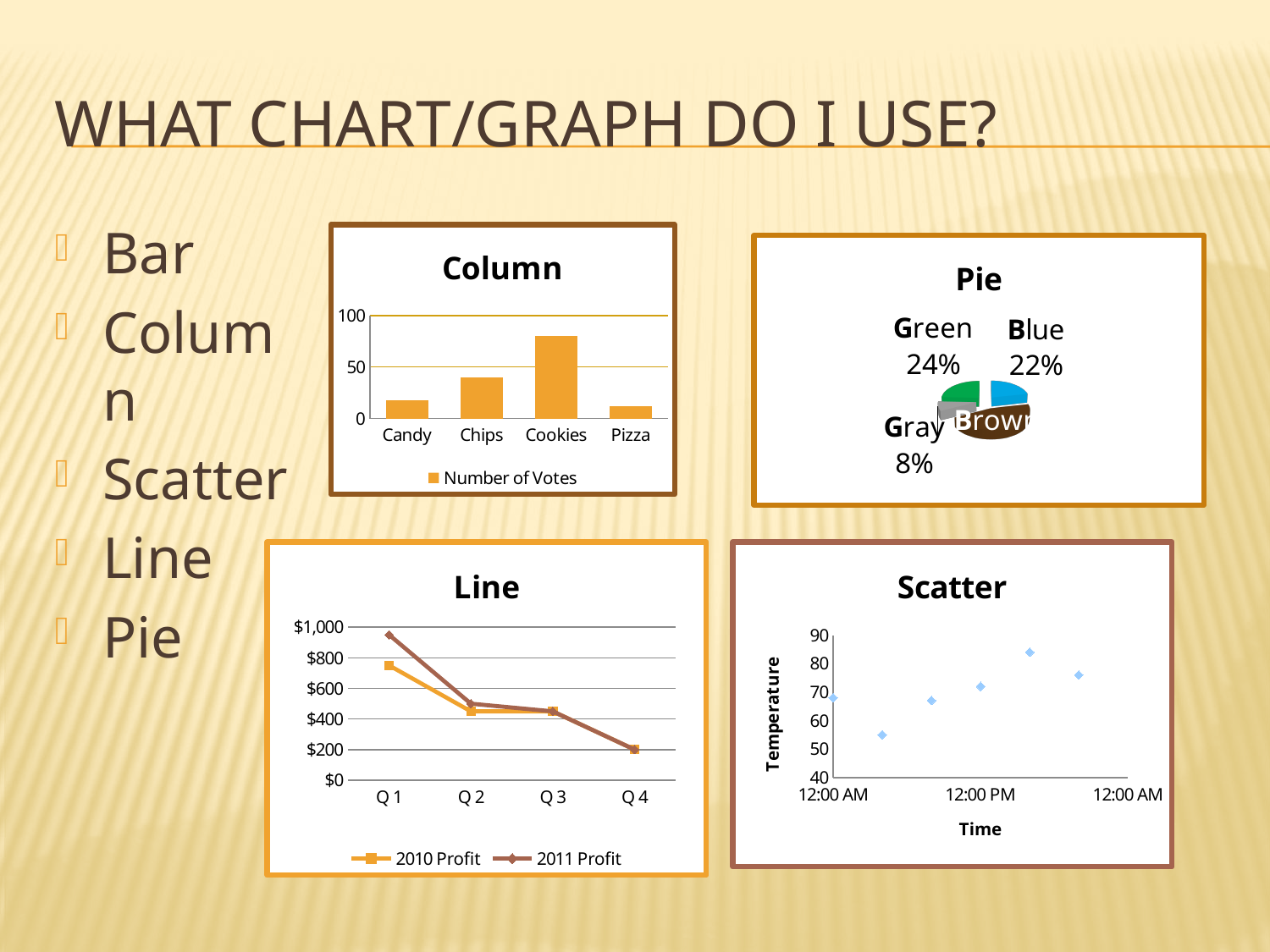
In the "Column" chart, which category has the highest number of votes? Cookies In the "Line" chart, is the 2011 Profit value for Q 1 greater or less than $800? greater In the "Pie" chart, what is the difference between the Green and Blue shares? 2% What type of chart is the chart titled "Column"? bar chart In the "Column" chart, is the value for Cookies greater or less than 50? greater In the "Pie" chart, which labeled slice has the smallest share? Gray How many categories are shown in the "Column" chart? 4 In the "Line" chart, do the profit values rise or fall from Q 1 to Q 4? fall In the "Column" chart, which category has the lowest number of votes? Pizza In the "Pie" chart, what share does Green have? 24% How many series does the legend of the "Line" chart list? 2 In the "Pie" chart, which is larger, Green or Blue? Green